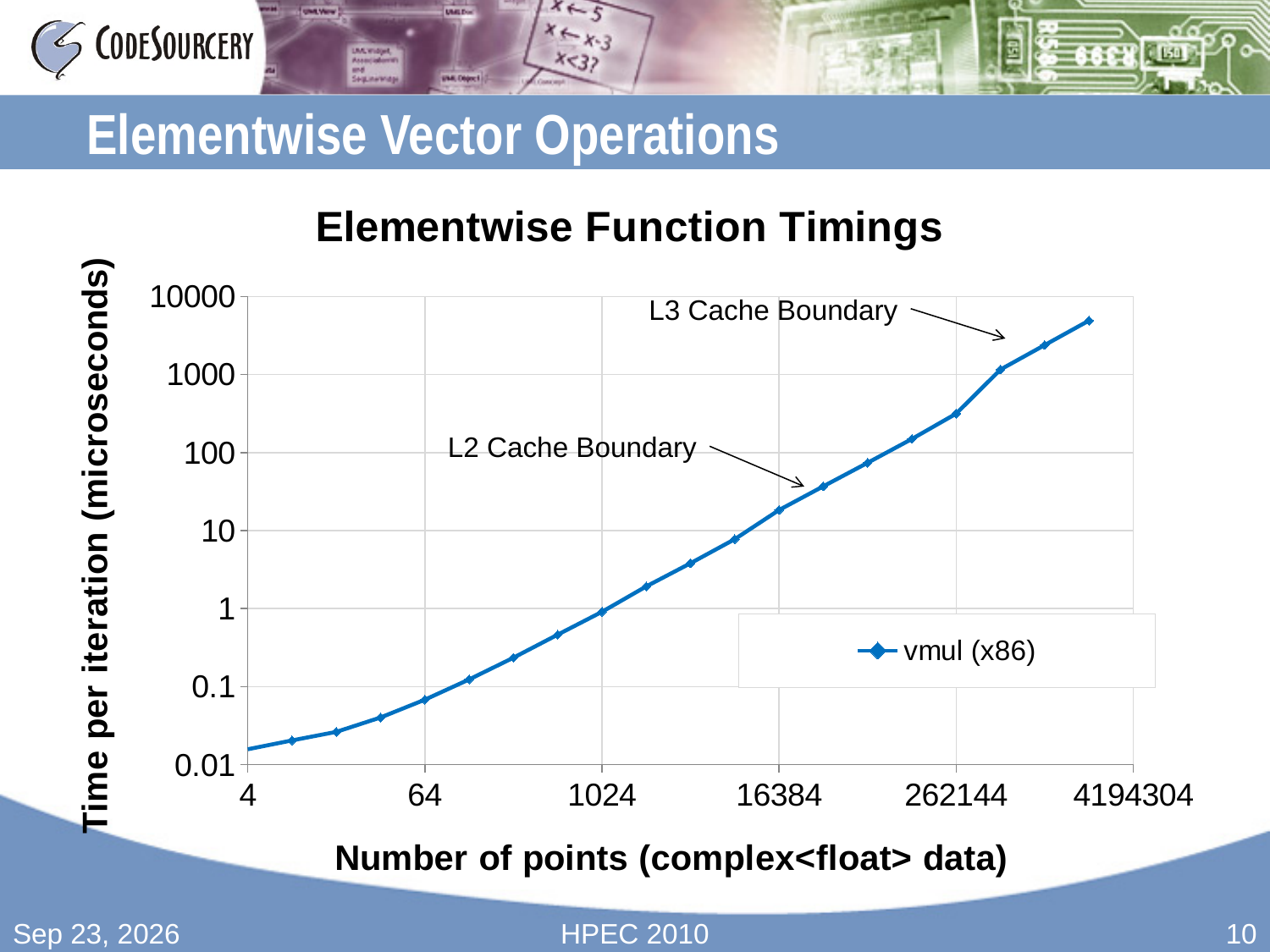
Is the value for 16384 points greater or less than 10 microseconds? greater What is the title of the chart? Elementwise Function Timings Is the value at the rightmost data point greater or less than 10000 microseconds? less What kind of chart is shown on the slide? line chart Which cache boundary annotation is placed at the higher number of points, L2 or L3? L3 Cache Boundary Is the value for 64 points greater or less than 0.1 microseconds? less Does the time per iteration rise or fall as the number of points increases along the x axis? rises How many data points are plotted on the vmul (x86) line? 20 How many series does the legend list? 1 What is the name of the series shown in the legend? vmul (x86)